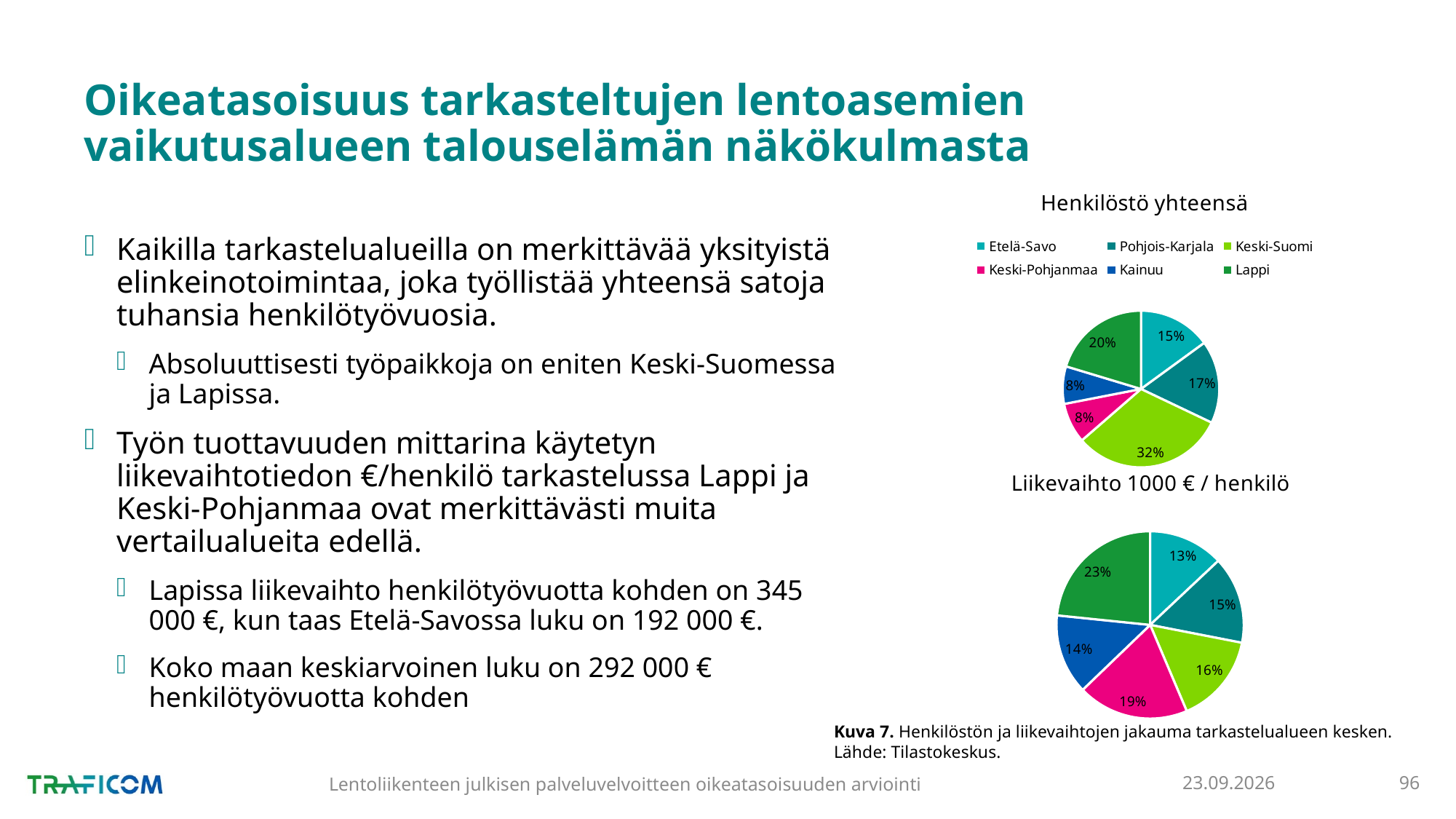
In the 'Liikevaihto 1000 € / henkilö' pie chart, which region has the largest share? Lappi What is the title of the upper chart on the slide? Henkilöstö yhteensä How many regions does the legend of the 'Henkilöstö yhteensä' chart list? 6 In the 'Liikevaihto 1000 € / henkilö' pie chart, what share does Keski-Pohjanmaa have? 19% In the 'Henkilöstö yhteensä' pie chart, what share does Kainuu have? 8% What type of chart is 'Liikevaihto 1000 € / henkilö'? Pie chart In the 'Henkilöstö yhteensä' pie chart, what is the difference between the shares of Keski-Suomi and Pohjois-Karjala? 15 percentage points In the 'Henkilöstö yhteensä' pie chart, what share does Keski-Suomi have? 32% In the 'Henkilöstö yhteensä' pie chart, which region has the largest share? Keski-Suomi In the 'Liikevaihto 1000 € / henkilö' pie chart, which region has the smallest share? Etelä-Savo In the 'Liikevaihto 1000 € / henkilö' pie chart, which is larger, the share of Kainuu or the share of Keski-Suomi? Keski-Suomi